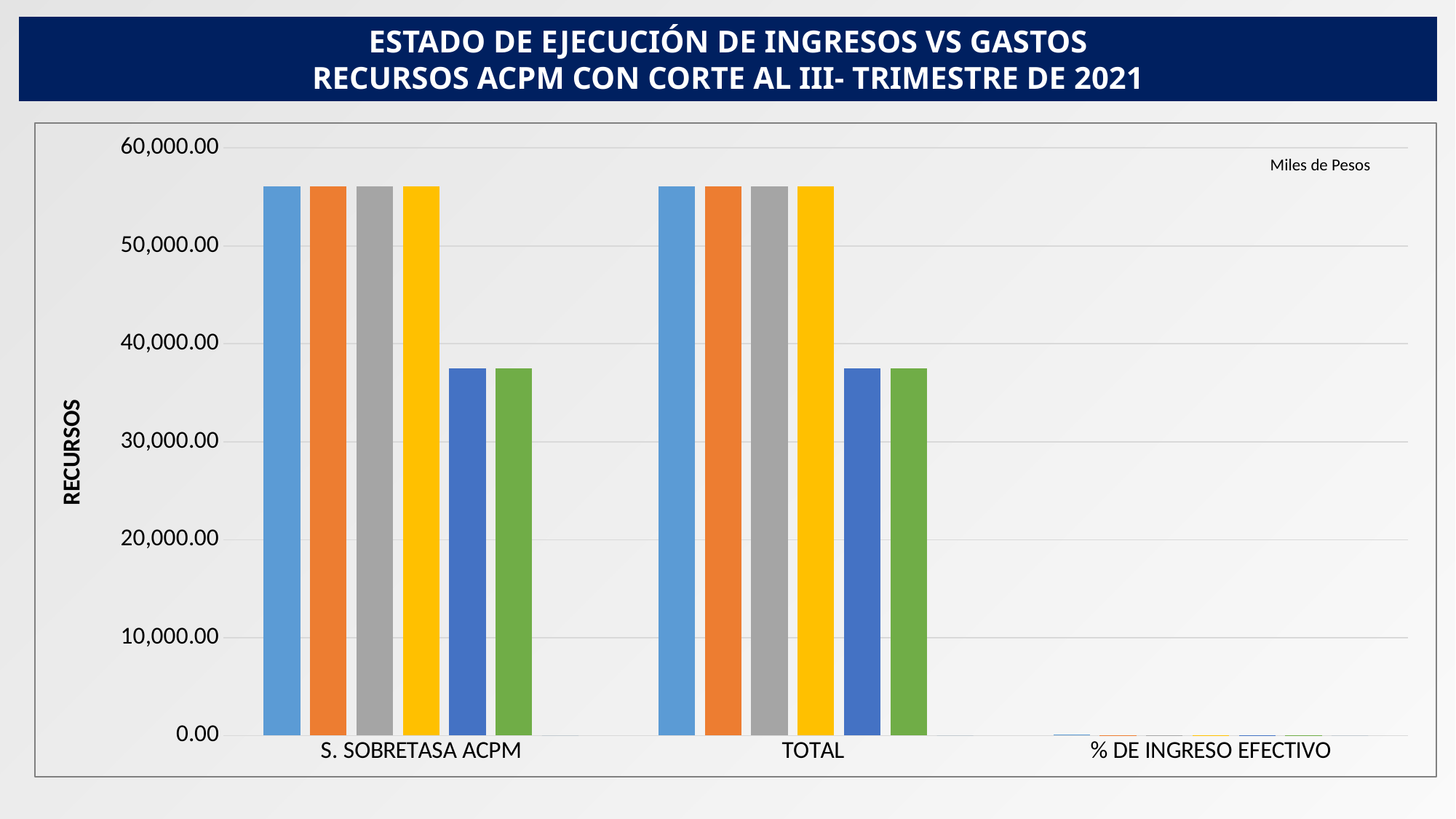
What unit note is printed in the top right corner of the chart area? Miles de Pesos Is the value of the yellow bar for TOTAL greater or less than 60,000.00? less How many categories are shown on the x axis of the chart? 3 Which category has the lowest bars in the chart? % DE INGRESO EFECTIVO Is the value of the light blue bar for S. SOBRETASA ACPM greater or less than 50,000.00? greater Is the value of the dark blue bar for S. SOBRETASA ACPM greater or less than 30,000.00? greater What kind of chart is shown on the slide? bar chart Within the S. SOBRETASA ACPM category, which is larger: the orange bar or the green bar? the orange bar How many bars are plotted for the S. SOBRETASA ACPM category? 6 What is the label of the vertical axis of the chart? RECURSOS